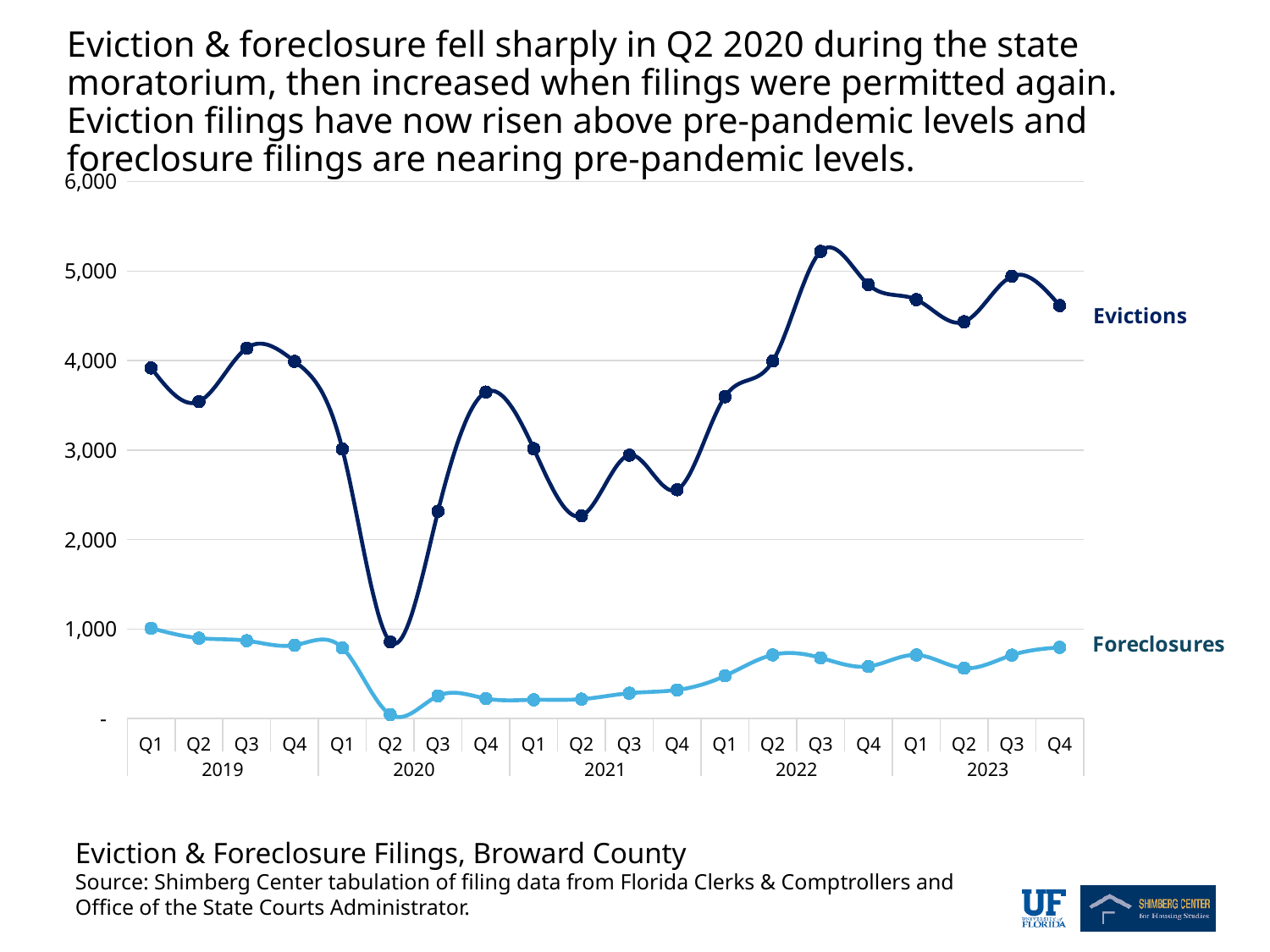
In which quarter does the Foreclosures line reach its lowest value? Q2 2020 In which quarter does the Evictions line reach its lowest value? Q2 2020 Do Foreclosures rise or fall from Q1 2019 to Q2 2020? Fall Is the Evictions value for Q4 2021 greater or less than 3,000? less In which quarter does the Evictions line reach its highest value? Q3 2022 What is the title of the chart shown below the plot area? Eviction & Foreclosure Filings, Broward County Is the Evictions value for Q3 2022 greater or less than 5,000? greater Which is higher for Evictions: Q3 2022 or Q3 2023? Q3 2022 Is the Evictions value for Q2 2020 greater or less than 1,000? less What type of chart is shown on the slide? Line chart How many quarterly data points does each line on the chart have? 20 How many series are plotted on the chart? 2